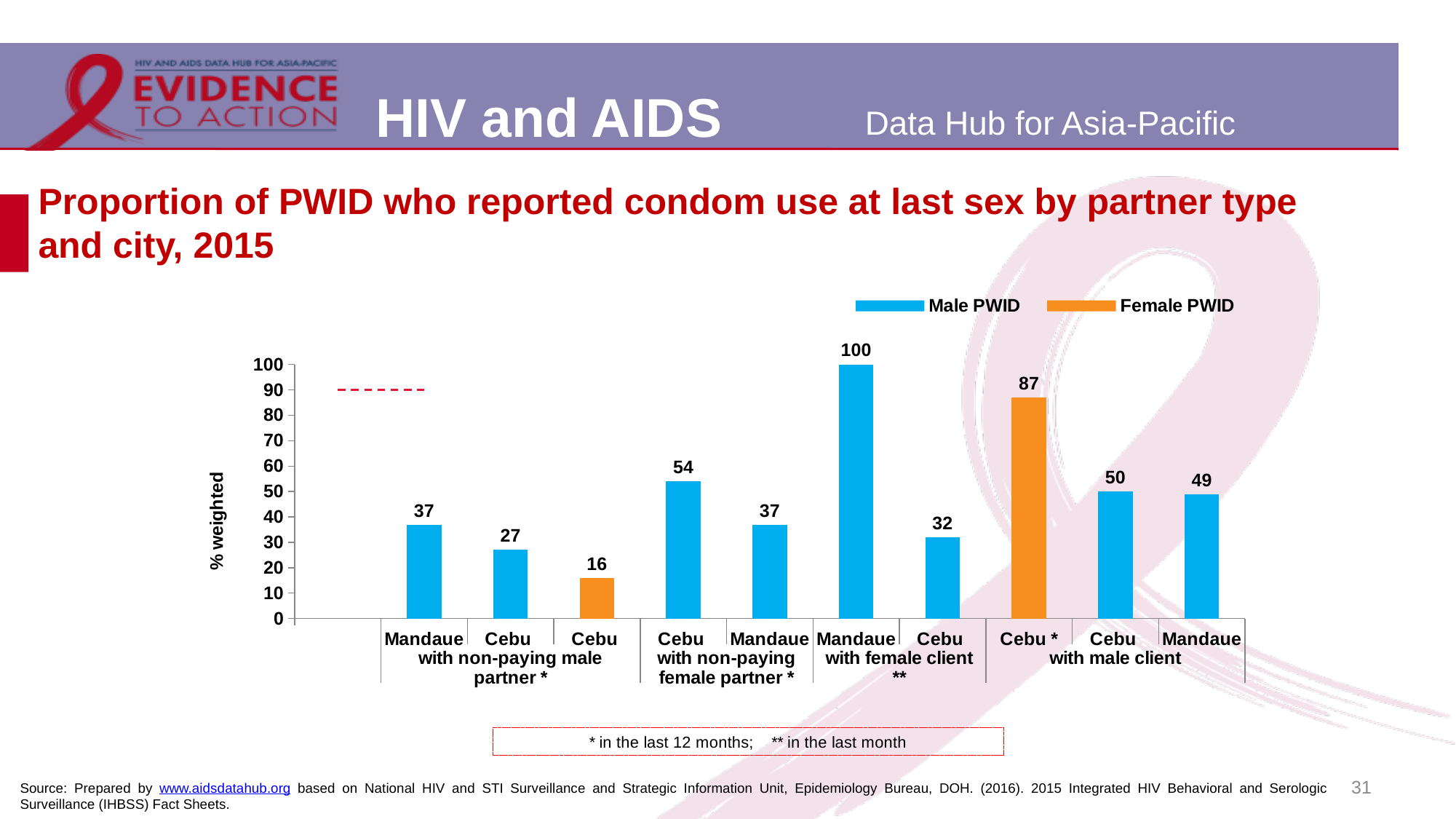
What is the difference between the Male PWID values for Mandaue and Cebu with female client? 68 Which is larger for Cebu with male client: the Female PWID value or the Male PWID value? Female PWID (87) Which bar has the lowest value on the chart? Female PWID, Cebu with non-paying male partner (16) What kind of chart is shown on the slide? Bar chart What is the difference between the Male PWID values for Cebu and Mandaue with non-paying female partner? 17 What is the label of the vertical axis? % weighted What is the value for Male PWID in Mandaue with female client? 100 What is the value for Female PWID in Cebu with male client? 87 What is the value for Female PWID in Cebu with non-paying male partner? 16 How many series does the legend list? 2 What is the value for Male PWID in Cebu with non-paying male partner? 27 Which bar has the highest value on the chart? Male PWID, Mandaue with female client (100)